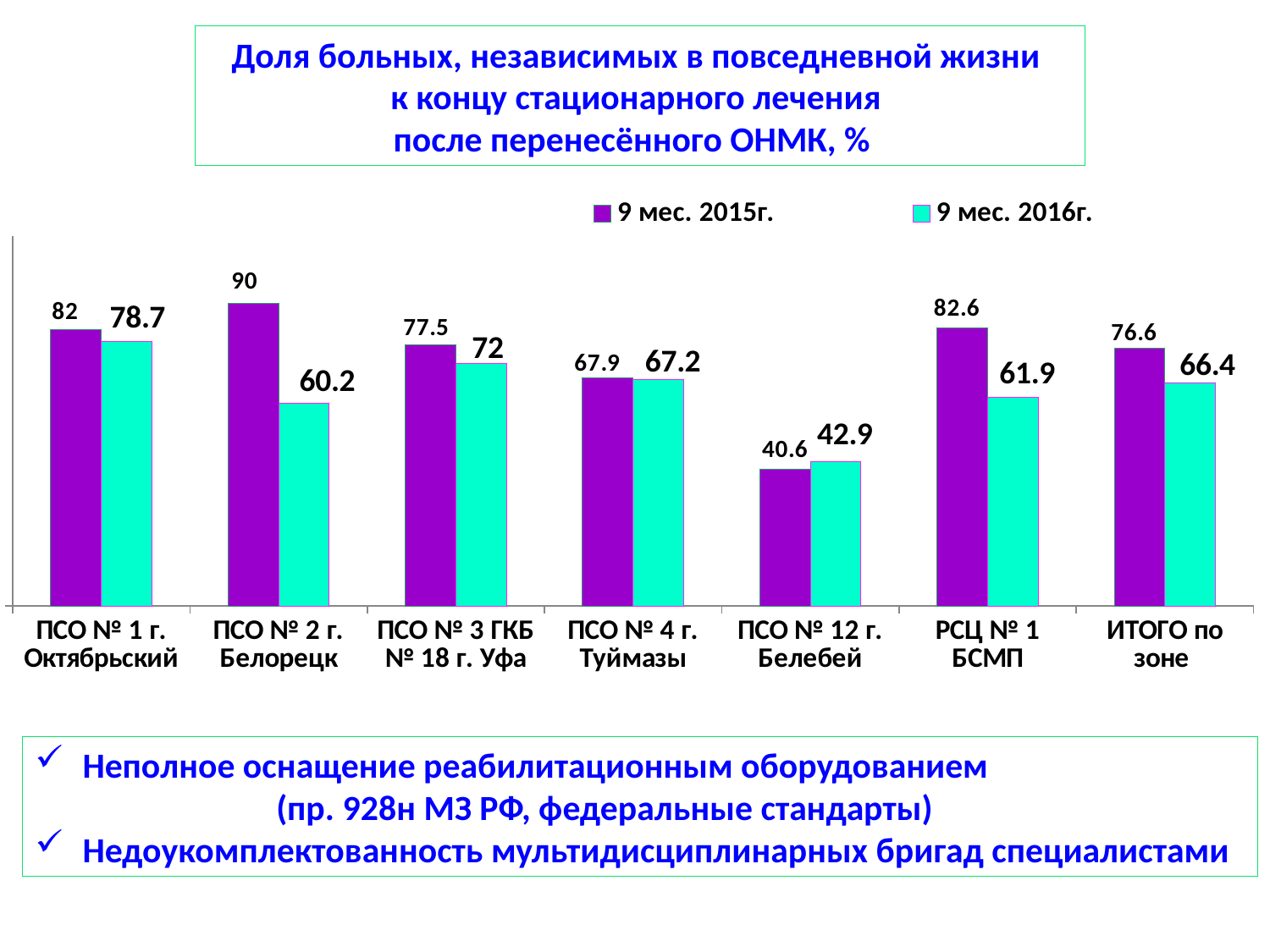
How many categories are shown on the x axis? 7 What kind of chart is shown on the slide? bar chart What is the difference between the 9 мес. 2015г. and 9 мес. 2016г. values for ПСО № 2 г. Белорецк? 29.8 Which colour represents the 9 мес. 2016г. series? cyan How many series does the legend list? 2 What is the difference between the 9 мес. 2015г. and 9 мес. 2016г. values for РСЦ № 1 БСМП? 20.7 For ПСО № 12 г. Белебей, which series has the larger value: 9 мес. 2015г. or 9 мес. 2016г.? 9 мес. 2016г. What is the value for ИТОГО по зоне in the 9 мес. 2015г. series? 76.6 What is the value for РСЦ № 1 БСМП in the 9 мес. 2016г. series? 61.9 What is the value for ПСО № 2 г. Белорецк in the 9 мес. 2015г. series? 90 Which category has the highest value in the 9 мес. 2015г. series? ПСО № 2 г. Белорецк Which category has the lowest value in the 9 мес. 2016г. series? ПСО № 12 г. Белебей